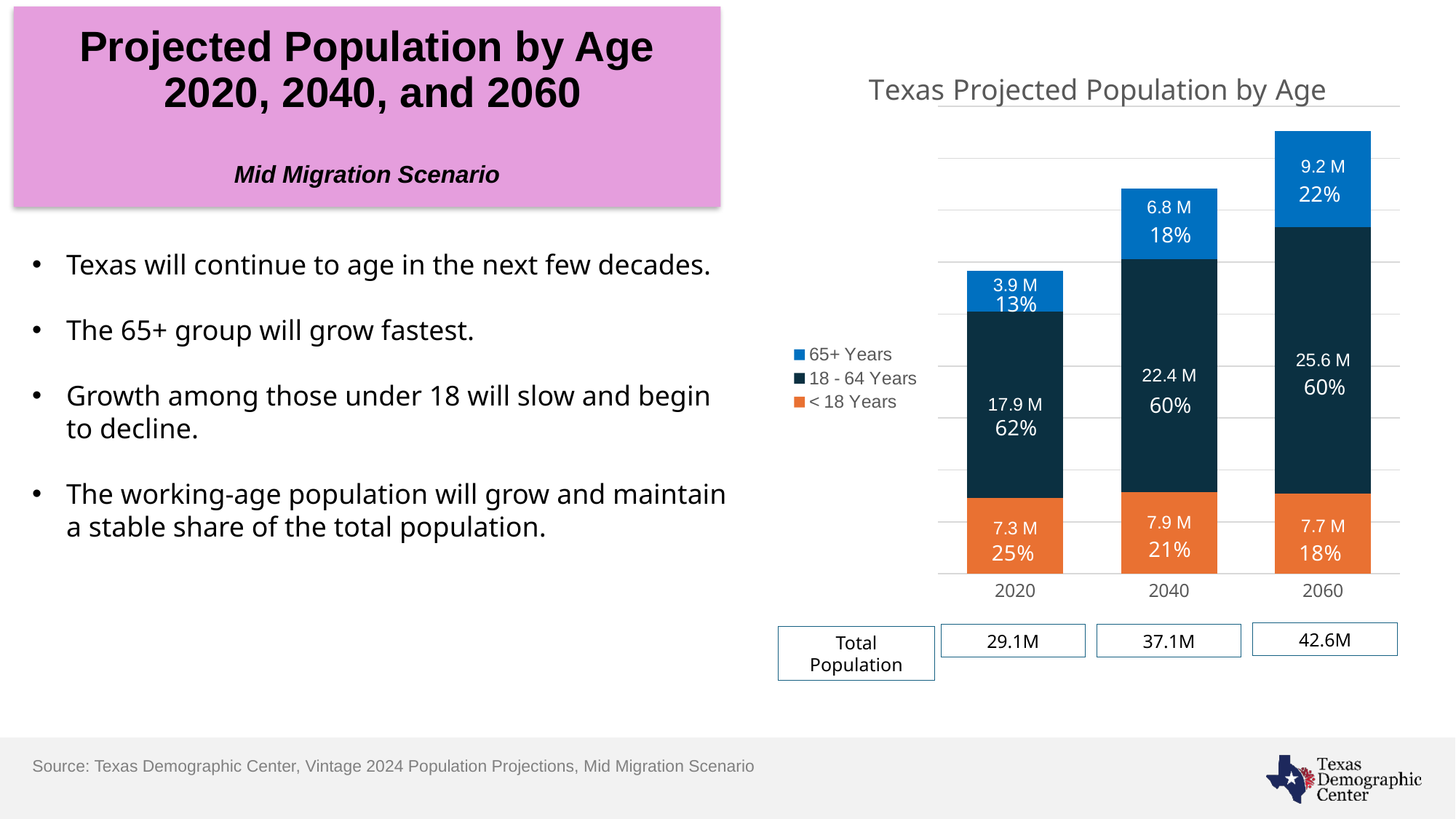
How many series does the legend list? 3 How many years are shown on the x axis? 3 Is the < 18 Years population larger in 2040 or in 2060? 2040 What is the projected 18 - 64 Years population in 2040? 22.4 M What percentage of the 2020 population is under 18 years? 25% How much larger is the 65+ Years population in 2040 than in 2020? 2.9 M Which year has the largest 65+ Years population? 2060 What is the projected 65+ Years population in 2060? 9.2 M What kind of chart is shown? Stacked bar chart Does the 65+ Years share of the population rise or fall from 2020 to 2060? Rise Which year has the smallest < 18 Years population? 2020 What is the total population shown for 2040? 37.1M